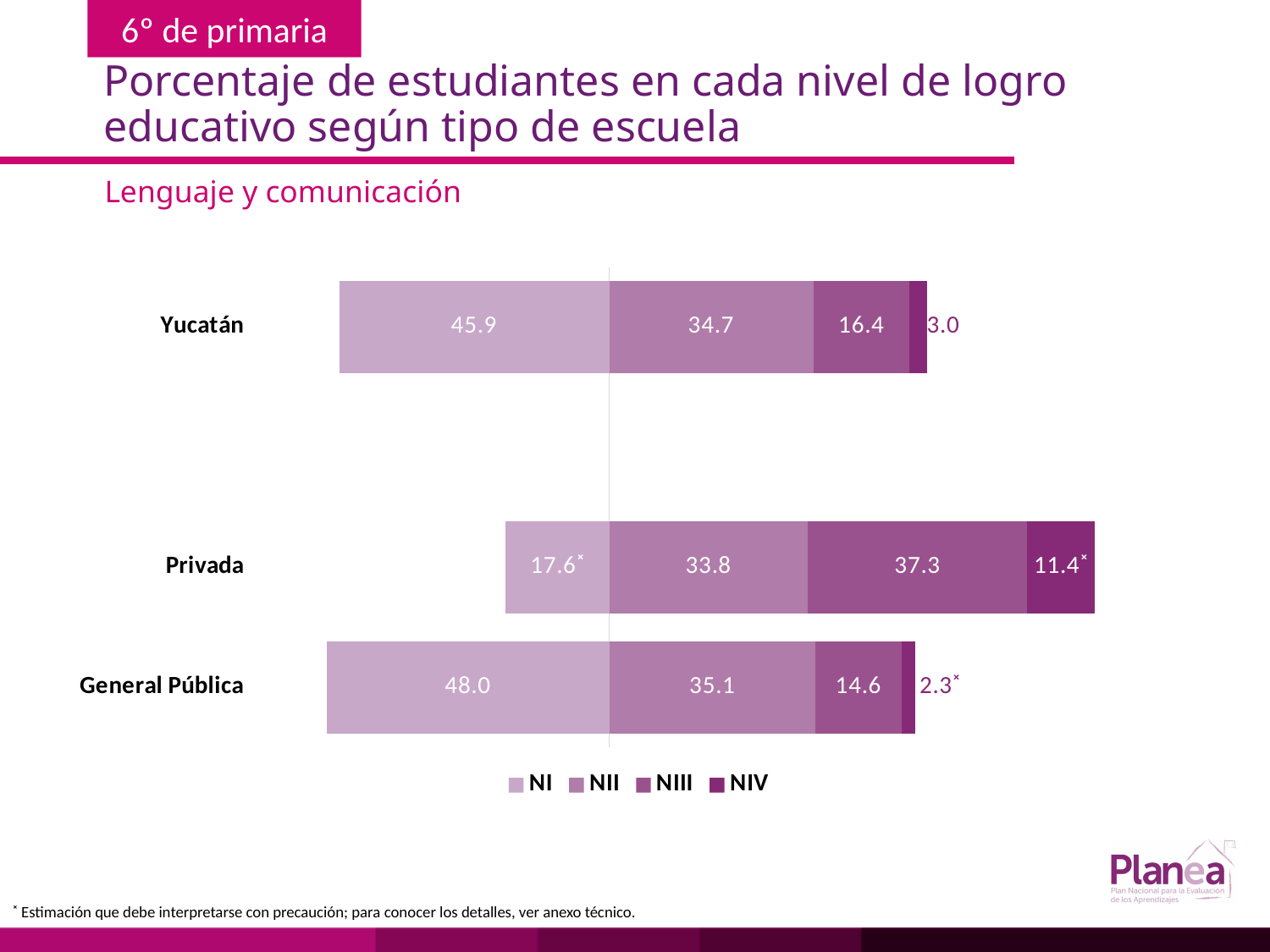
Which category has the highest NI value? General Pública What is the total of the stacked bar for Yucatán? 100.0 What is the NIV value for General Pública? 2.3 How many series does the legend list? 4 What is the difference between the NIII values for Privada and Yucatán? 20.9 What is the NIII value for Privada? 37.3 What is the NII value for General Pública? 35.1 What is the NI value for Yucatán? 45.9 How many categories are shown on the chart? 3 What kind of chart is shown? Stacked bar chart Which category has the lowest NIV value? General Pública Which is larger, the NII value for Yucatán or the NII value for Privada? Yucatán